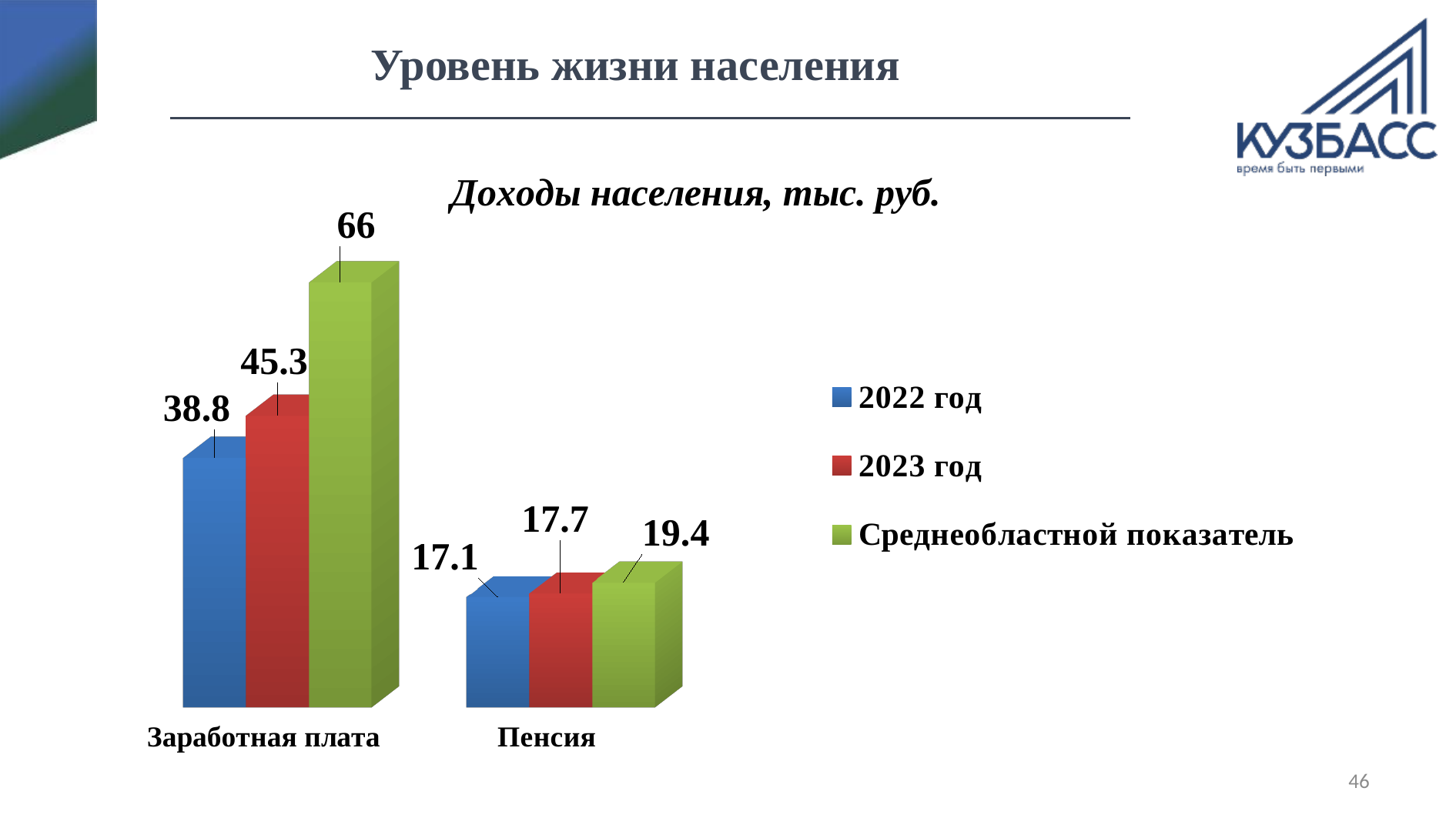
What kind of chart is shown on the slide? Bar chart What is the difference between the Среднеобластной показатель and 2023 год values in the Заработная плата category? 20.7 How many categories are shown on the x axis? 2 Which series has the lowest value in the Пенсия category? 2022 год What is the value for Среднеобластной показатель in the Пенсия category? 19.4 How many series does the legend list? 3 Which series has the highest value in the Заработная плата category? Среднеобластной показатель What is the value for 2022 год in the Пенсия category? 17.1 What is the value for 2022 год in the Заработная плата category? 38.8 Which is larger: the 2023 год value for Заработная плата or the 2023 год value for Пенсия? Заработная плата What is the value for 2023 год in the Заработная плата category? 45.3 What is the difference between the 2023 год and 2022 год values in the Пенсия category? 0.6